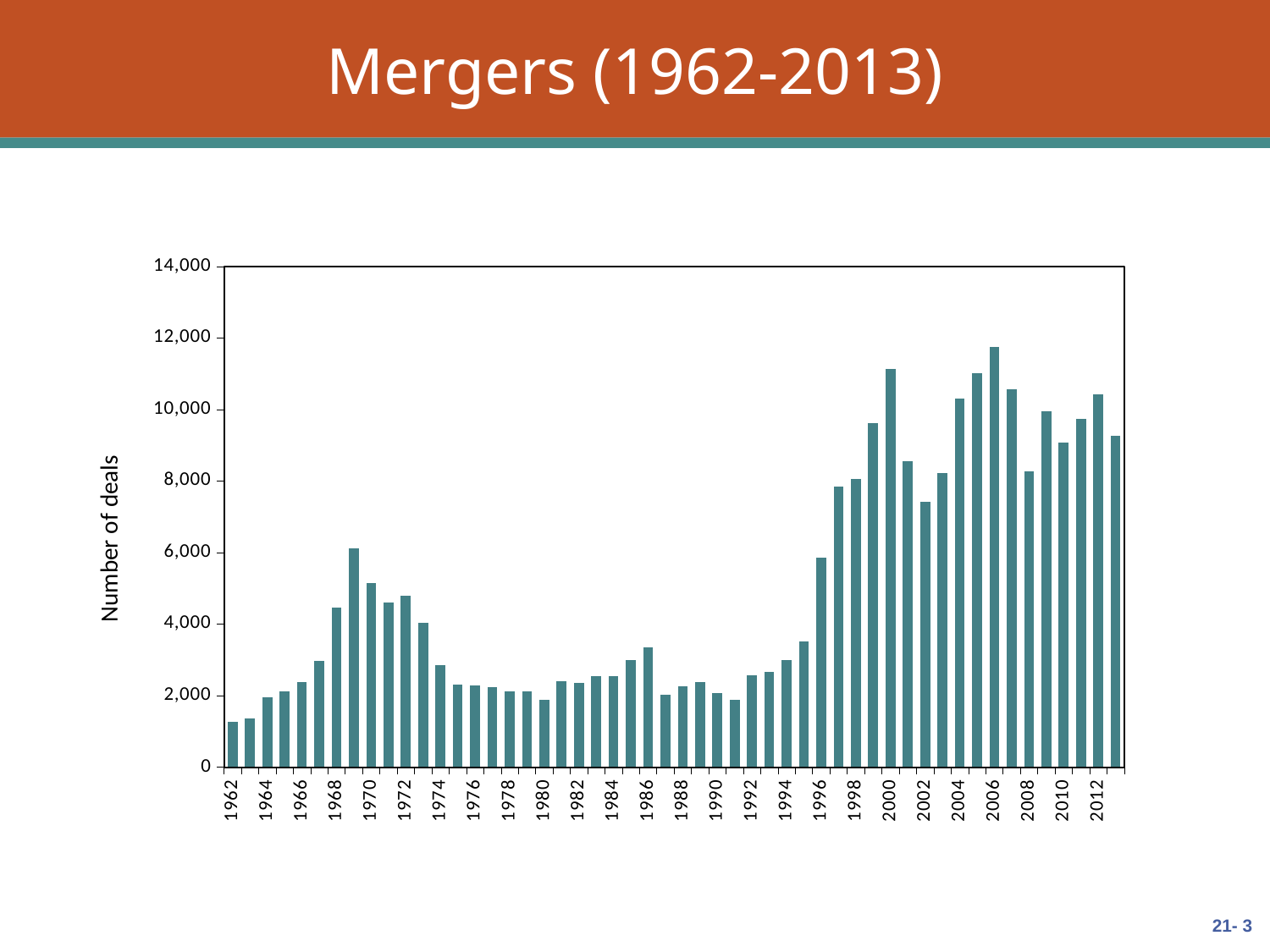
Is the number of deals in 2000 greater or less than 10,000? greater What is the title of the chart? Mergers (1962-2013) Is the number of deals in 1969 greater or less than 4,000? greater Which year had more deals, 1969 or 1970? 1969 What kind of chart is shown on the slide? Bar chart Is the number of deals in 2002 greater or less than 8,000? less Does the number of deals rise or fall from 1962 to 1969? rise What is the label on the vertical axis? Number of deals Which year has the highest number of deals? 2006 Which year had more deals, 2000 or 2001? 2000